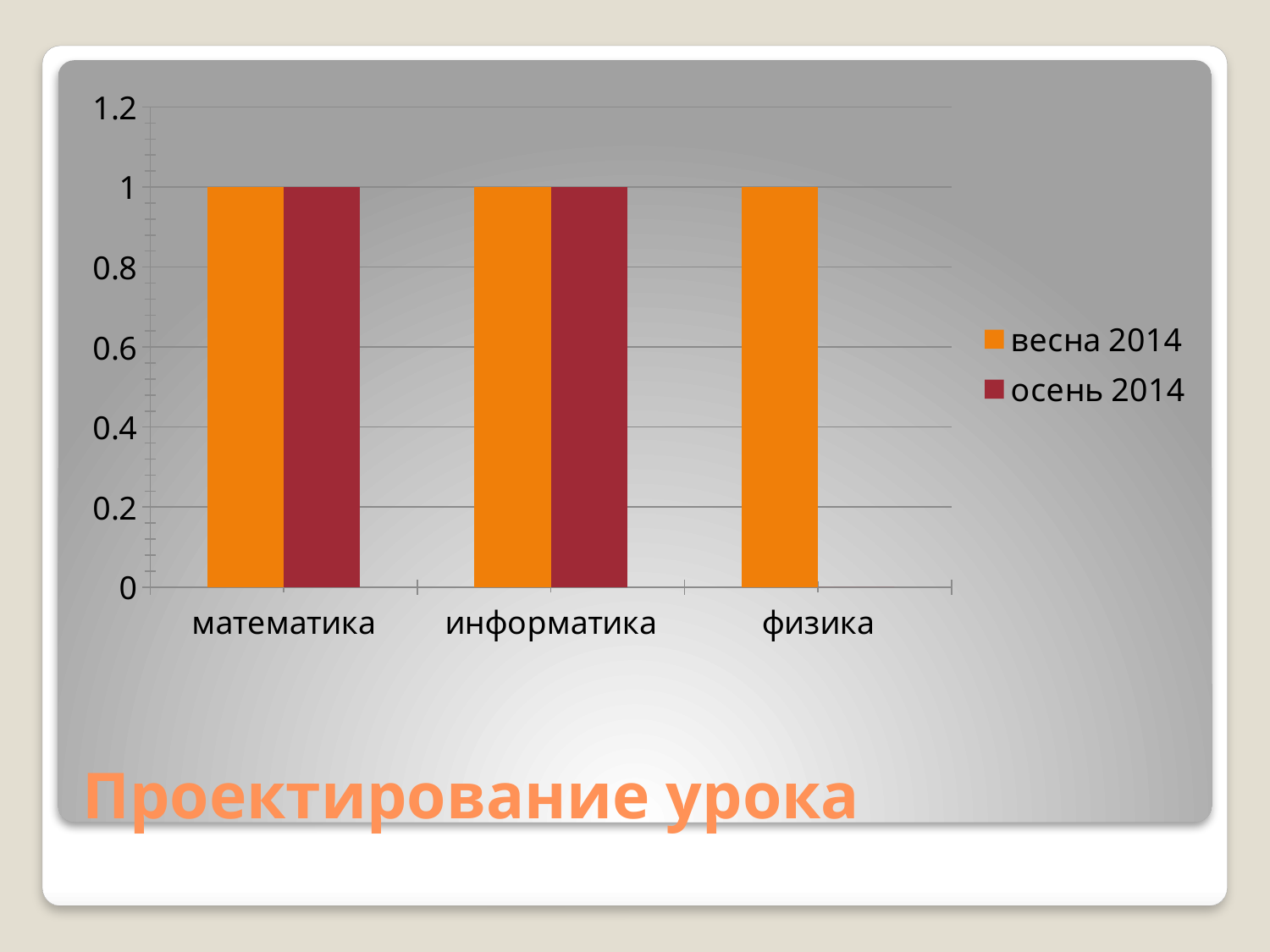
What is the value for информатика in the осень 2014 series? 1 What is the value for физика in the весна 2014 series? 1 What are the two series listed in the chart's legend? весна 2014 and осень 2014 What is the difference between the весна 2014 values for математика and информатика? 0 What kind of chart is shown on the slide? bar chart Which category has no bar for the осень 2014 series? физика How many categories are shown on the x axis of the chart? 3 Is the value for математика in the осень 2014 series greater or less than 1.2? less How many series does the chart's legend list? 2 What is the value for математика in the весна 2014 series? 1 Is the value for информатика in the весна 2014 series greater or less than 0.8? greater What is the highest value shown on the chart's vertical axis? 1.2